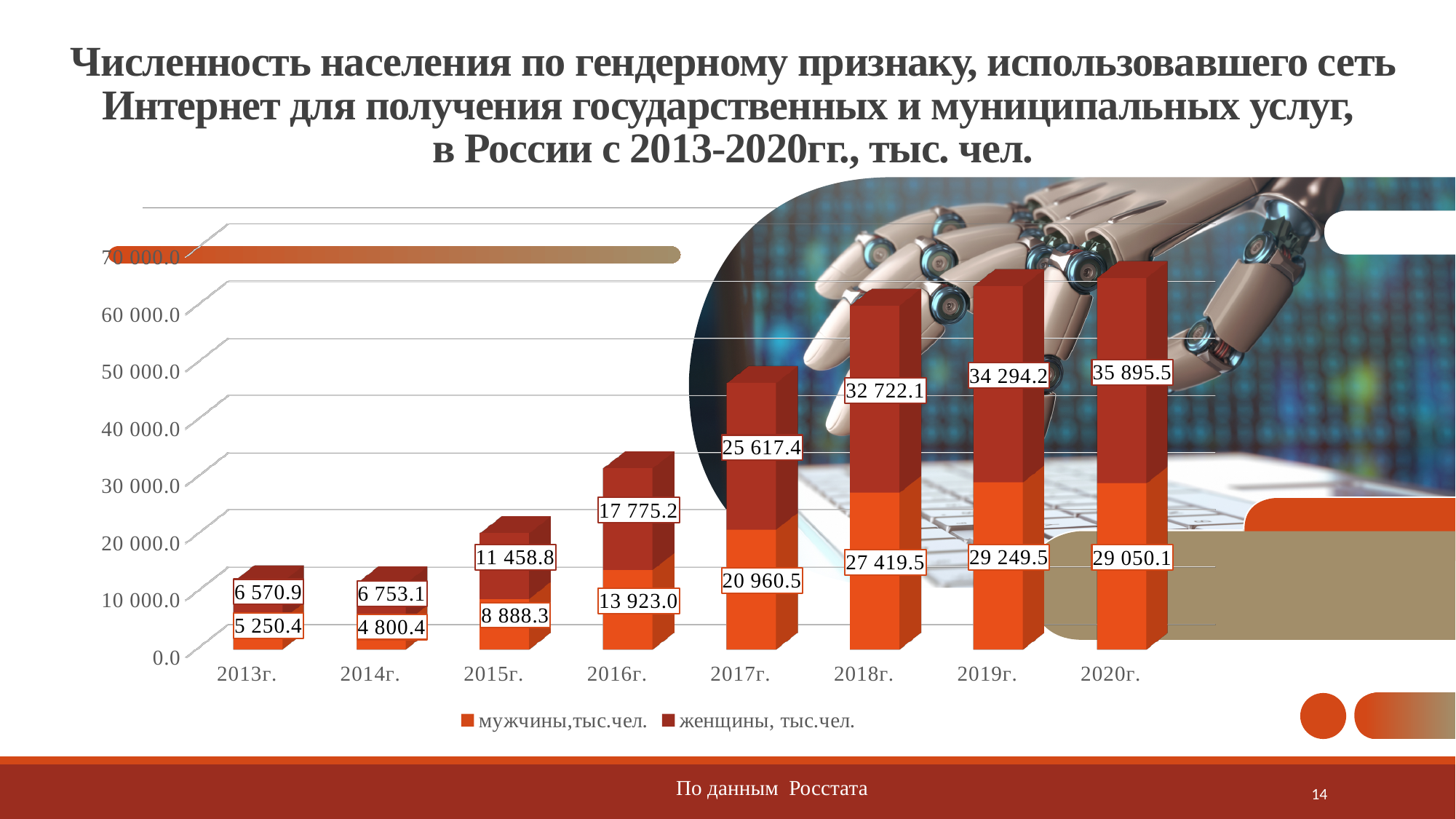
Which is larger: the мужчины value in 2019г. or in 2020г.? 2019г. How many series does the legend list? 2 What is the value for женщины (women) in 2016г.? 17 775.2 What is the total of the stacked bar for 2013г.? 11 821.3 In which year is the value for мужчины (men) the lowest? 2014г. How many years are shown on the x axis? 8 What is the difference between the женщины and мужчины values in 2020г.? 6 845.4 What is the value for мужчины (men) in 2013г.? 5 250.4 What is the total of the stacked bar for 2020г.? 64 945.6 What is the value for мужчины (men) in 2020г.? 29 050.1 In which year is the value for женщины (women) the highest? 2020г. What kind of chart is shown on the slide? Stacked bar chart